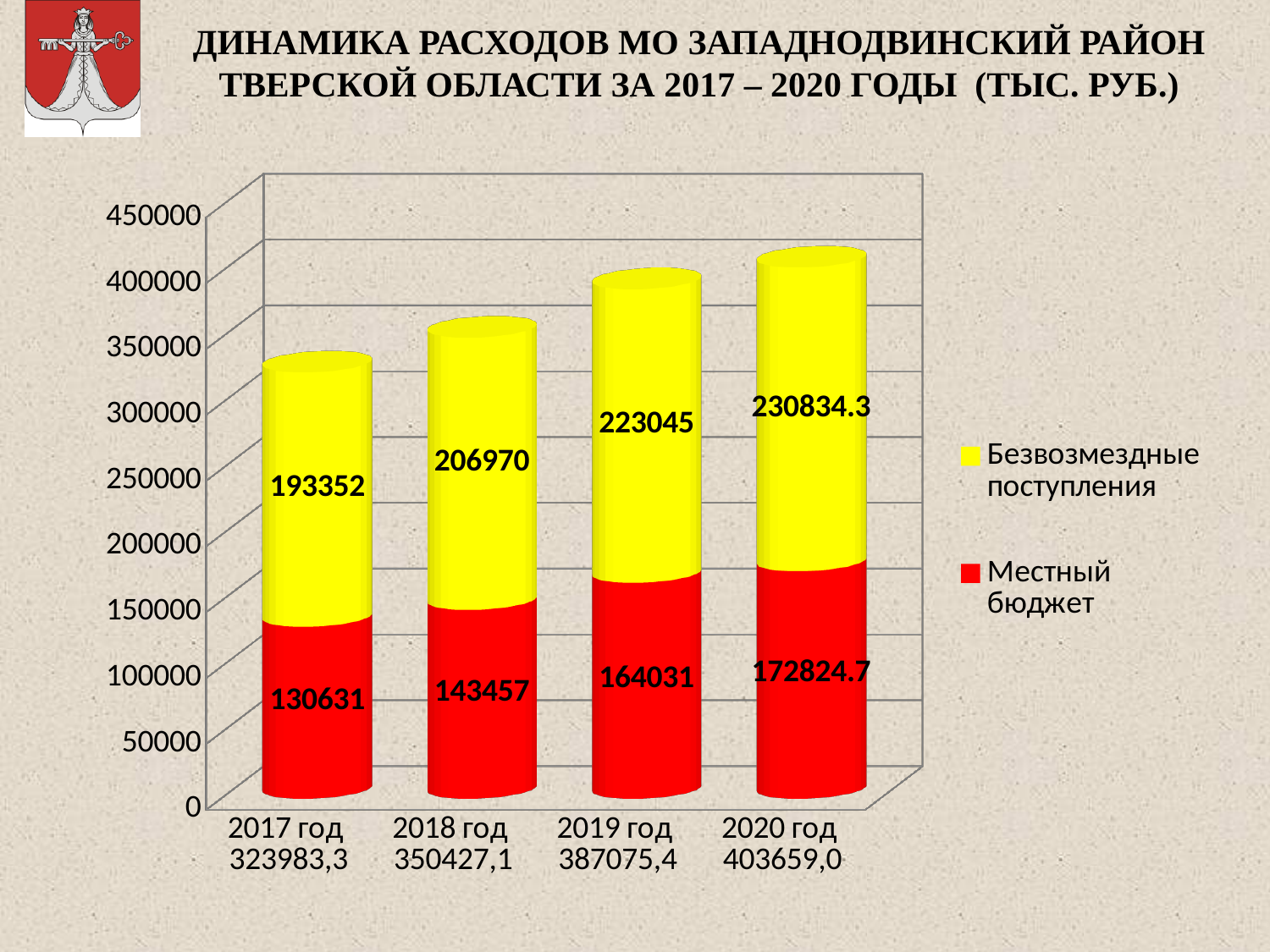
Is the total height of the 2017 год bar greater or less than 300000? greater What is the value of Безвозмездные поступления for 2020 год? 230834.3 In which year is Местный бюджет the highest? 2020 год What is the total of the stacked bar for 2020 год? 403659,0 What is the value of Местный бюджет for 2017 год? 130631 In which year is Безвозмездные поступления the lowest? 2017 год What kind of chart is shown on the slide? stacked bar chart What is the difference between Безвозмездные поступления in 2019 год and 2018 год? 16075 Do the total expenditures rise or fall from 2017 год to 2020 год? rise How many series does the legend list? 2 How many years are shown on the x axis? 4 Which is larger in 2019 год: Безвозмездные поступления or Местный бюджет? Безвозмездные поступления